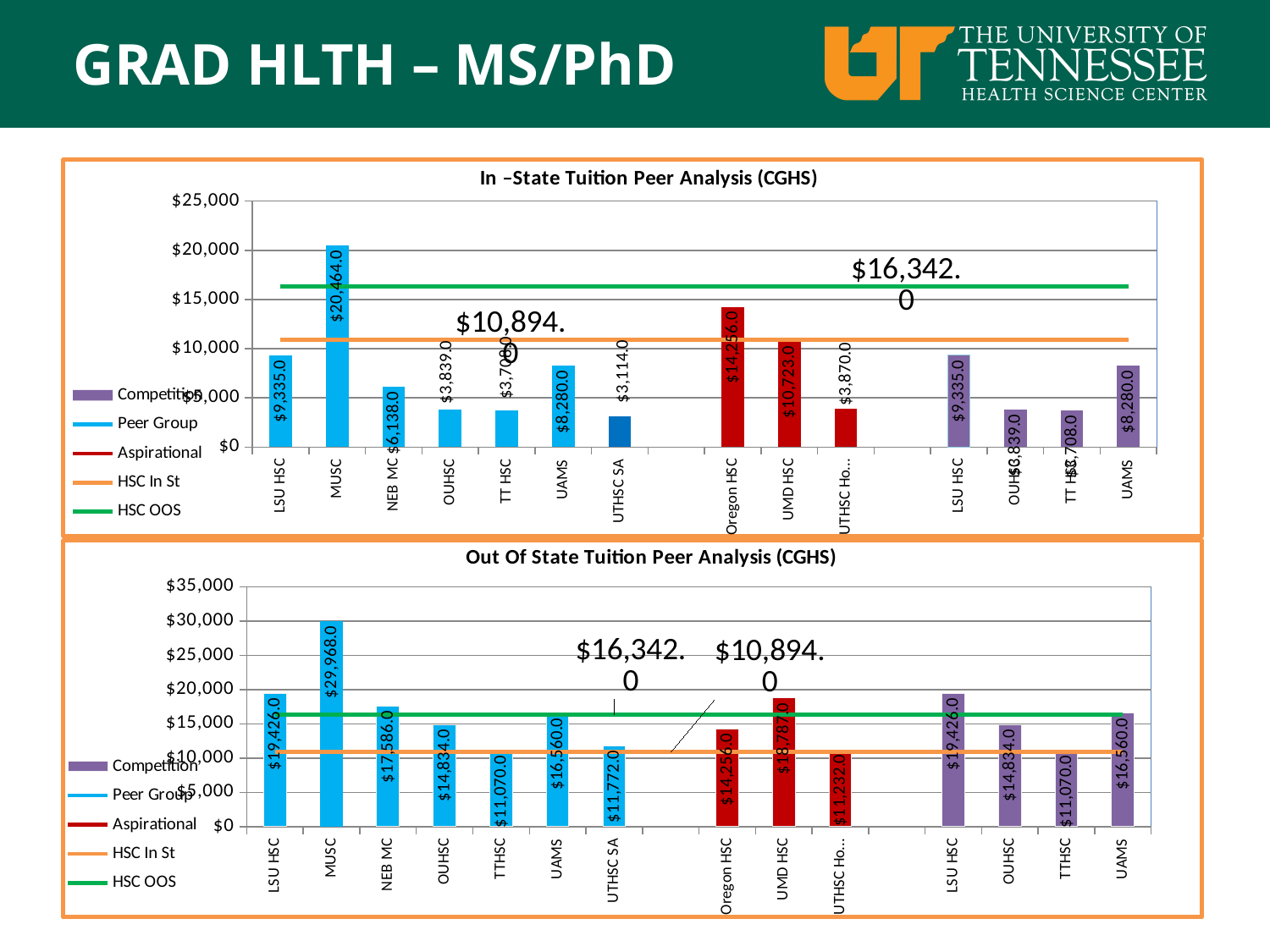
In the Out Of State Tuition Peer Analysis chart, what is the value for MUSC? $29,968.0 In the Out Of State Tuition Peer Analysis chart, which institution has the highest tuition? MUSC In the Out Of State Tuition Peer Analysis chart, which is larger, NEB MC or OUHSC? NEB MC In the In-State Tuition Peer Analysis chart, what is the value for Oregon HSC? $14,256.0 In the In-State Tuition Peer Analysis chart, which is larger, Oregon HSC or UMD HSC? Oregon HSC In the In-State Tuition Peer Analysis chart, which institution has the highest tuition? MUSC In the Out Of State Tuition Peer Analysis chart, what is the value for UMD HSC? $18,787.0 In the Out Of State Tuition Peer Analysis chart, is the value for MUSC greater or less than $25,000? greater In the Out Of State Tuition Peer Analysis chart, what is the difference between MUSC and LSU HSC? $10,542.0 In the In-State Tuition Peer Analysis chart, what is the difference between MUSC and Oregon HSC? $6,208.0 In the In-State Tuition Peer Analysis chart, what is the value for MUSC? $20,464.0 How many series does the legend of the In-State Tuition Peer Analysis chart list? 5